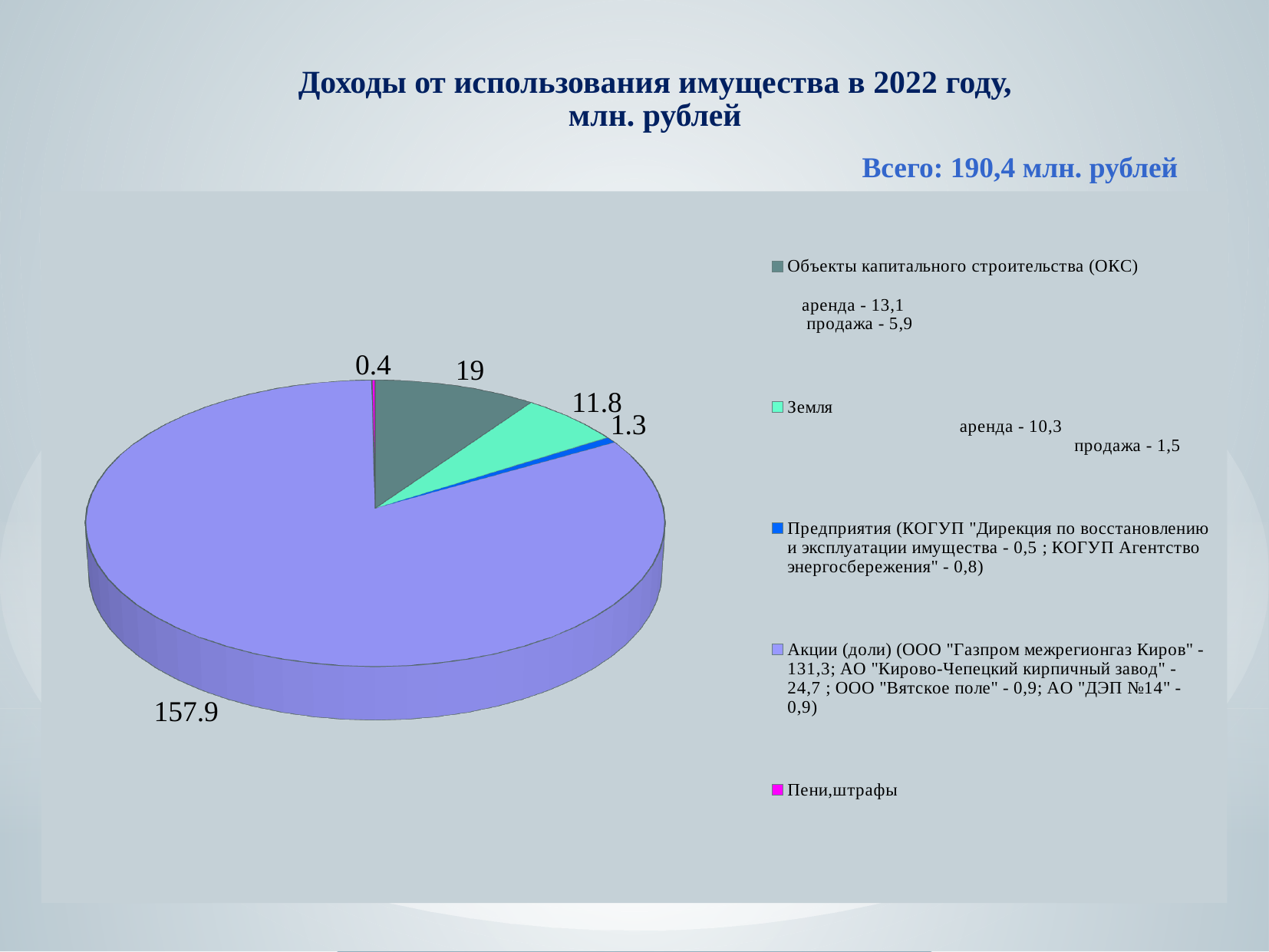
What is the value for Земля? 11.8 What is the value for Акции (доли) in the pie chart? 157.9 Which category has the smallest slice of the pie? Пени,штрафы What is the value for Пени,штрафы? 0.4 How many slices does the pie chart have? 5 Which category has the largest slice of the pie? Акции (доли) What total is stated on the slide for the income from use of property in 2022? 190,4 млн. рублей What is the difference between the values for Акции (доли) and Объекты капитального строительства (ОКС)? 138.9 What is the value for Объекты капитального строительства (ОКС)? 19 What kind of chart is shown on the slide? pie chart Which is larger, the value for Земля or the value for Объекты капитального строительства (ОКС)? Объекты капитального строительства (ОКС) What is the value for Предприятия? 1.3